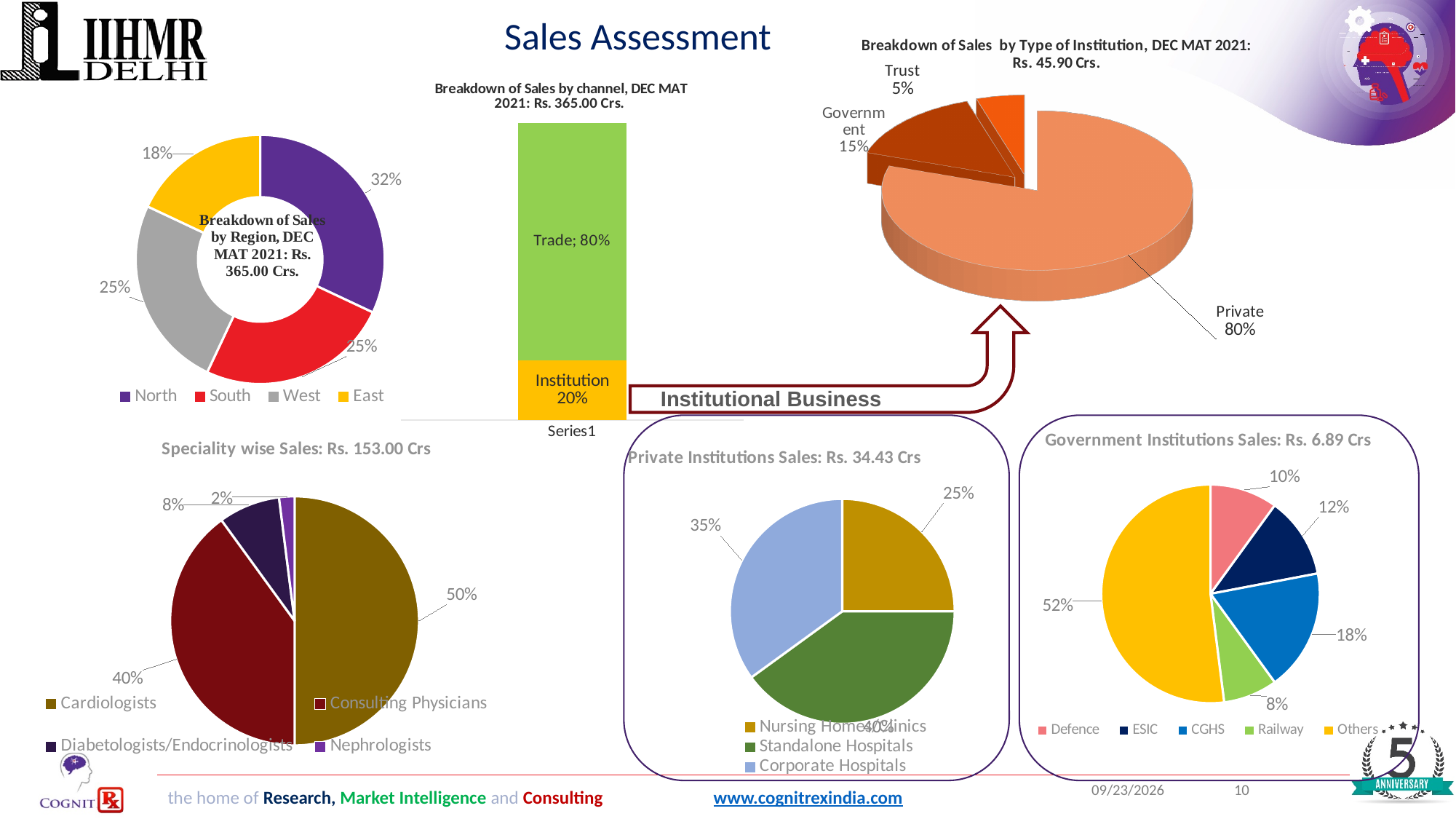
What total sales value is stated in the title of the 'Government Institutions Sales' pie chart? Rs. 6.89 Crs In the 'Speciality wise Sales' pie chart, what share do Nephrologists account for? 2% In the 'Private Institutions Sales' pie chart, which is larger: Standalone Hospitals or Corporate Hospitals? Standalone Hospitals In the 'Speciality wise Sales' pie chart, which speciality has the largest share? Cardiologists In the 'Breakdown of Sales by Region' donut chart, which region has the smallest share? East In the 'Breakdown of Sales by Region' donut chart, what share of sales does North account for? 32% In the 'Breakdown of Sales by Type of Institution' pie chart, what share does Government hold? 15% What kind of chart is the 'Breakdown of Sales by channel' chart? Stacked bar chart In the 'Breakdown of Sales by channel' chart, what percentage is attributed to Trade? 80% In the 'Breakdown of Sales by Type of Institution' pie chart, what is the difference between the Private and Trust shares? 75% In the 'Government Institutions Sales' pie chart, what share does CGHS hold? 18% In the 'Breakdown of Sales by Region' donut chart, how many regions does the legend list? 4